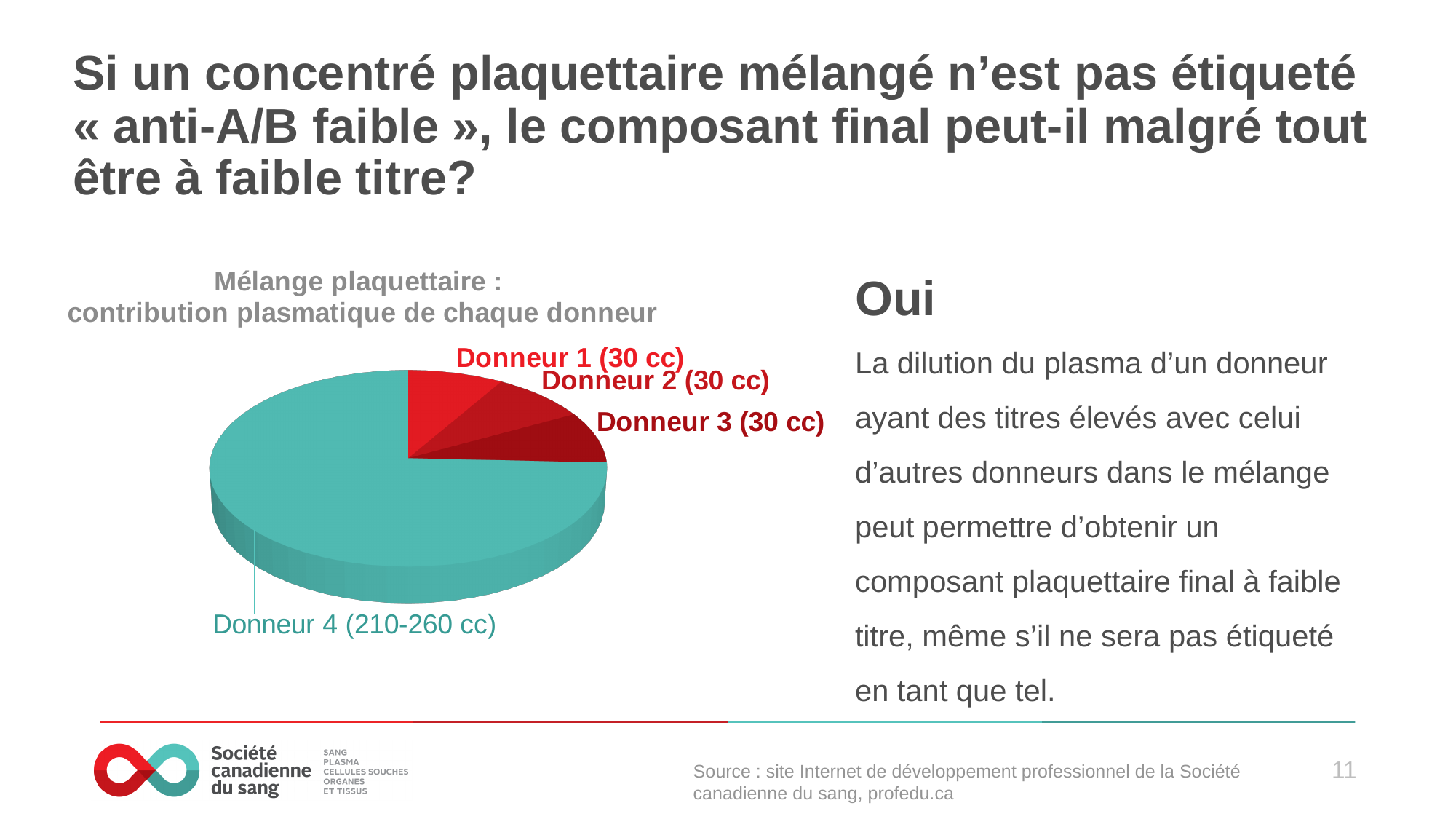
What is the plasma contribution of Donneur 3? 30 cc What is the plasma contribution of Donneur 2? 30 cc What colour is the slice for Donneur 4 in the pie chart? Teal Which contributes more plasma, Donneur 4 or Donneur 1? Donneur 4 Which donor contributes the largest share of plasma in the pie chart? Donneur 4 What kind of chart is shown on the slide? Pie chart How many donors (slices) are shown in the pie chart? 4 What is the plasma contribution of Donneur 4? 210-260 cc What is the plasma contribution of Donneur 1? 30 cc What is the title of the pie chart? Mélange plaquettaire : contribution plasmatique de chaque donneur